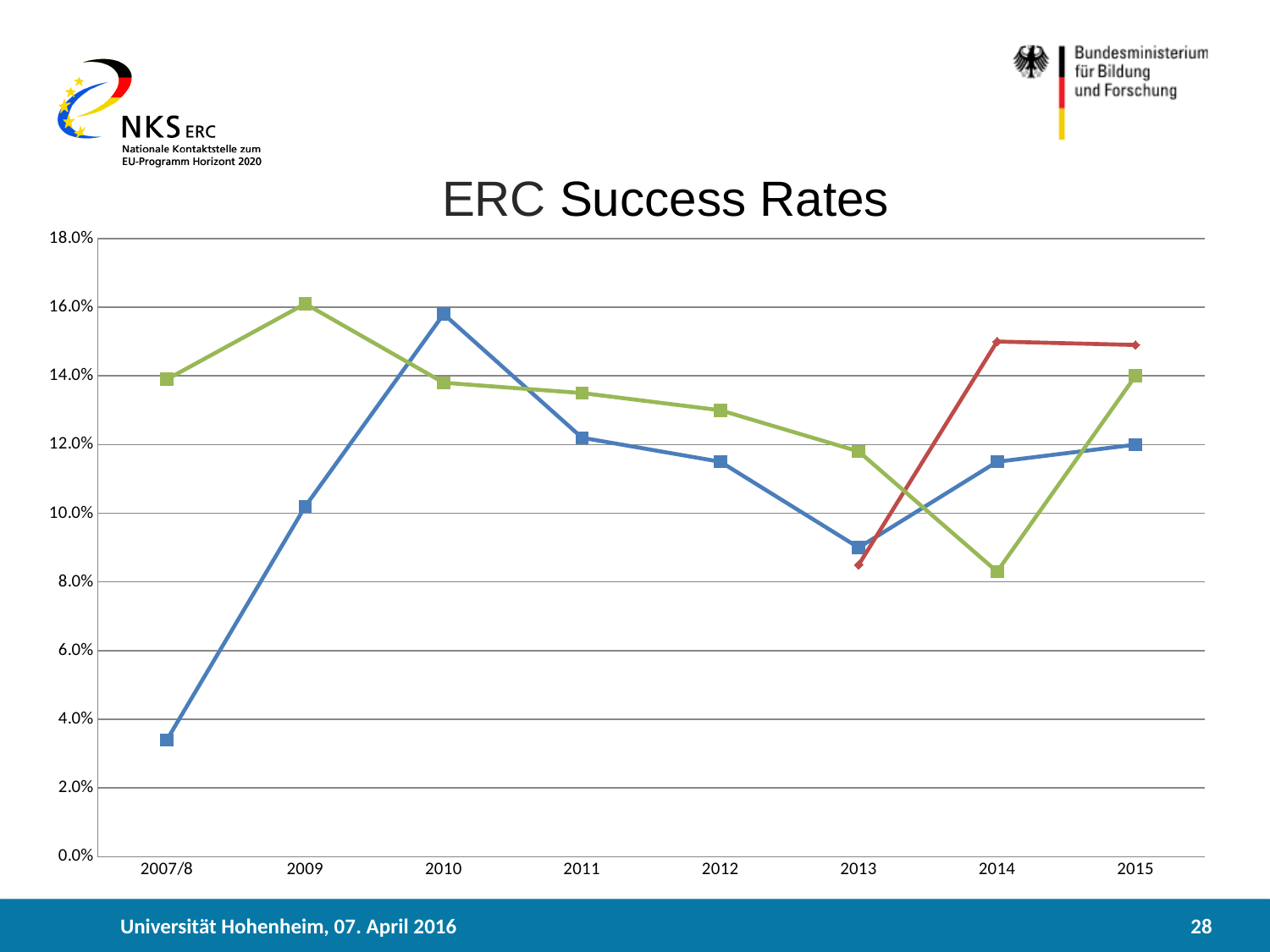
Does the green line rise or fall from 2010 to 2013? fall Is the value of the blue line for 2007/8 greater or less than 4.0%? less In 2015, which line has the higher value, the red line or the blue line? red line In 2013, which line has the higher value, the blue line or the green line? green line How many year categories are shown on the x axis? 8 Is the value of the blue line for 2013 greater or less than 10.0%? less In which year does the blue line reach its highest value? 2010 What kind of chart is shown on the slide? line chart What is the title of the chart? ERC Success Rates Is the value of the green line for 2014 greater or less than 10.0%? less